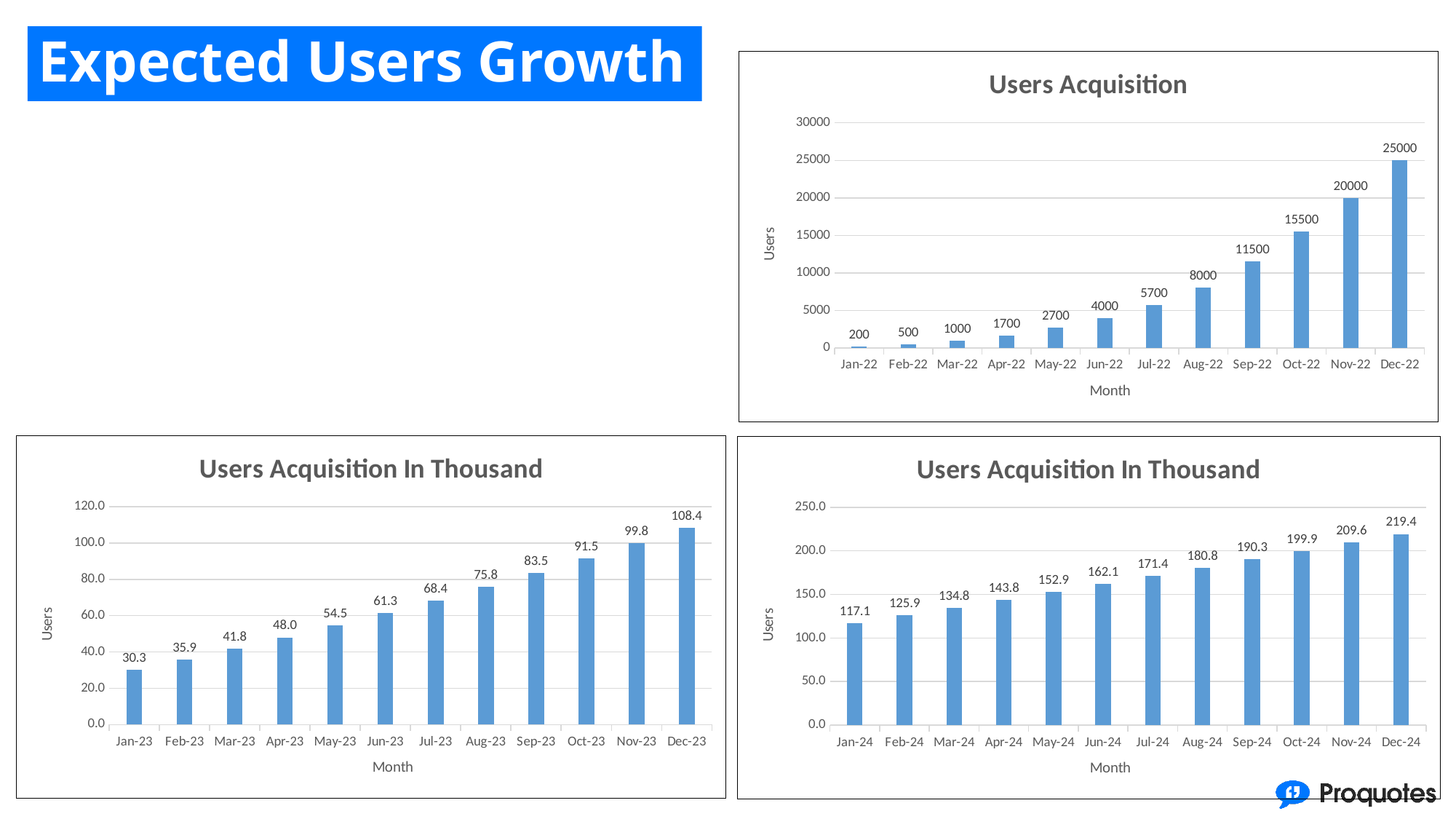
In the top-right chart titled 'Users Acquisition', which month has the lowest value? Jan-22 In the bottom-left chart titled 'Users Acquisition In Thousand', what is the difference between the values for Dec-23 and Jan-23? 78.1 In the top-right chart titled 'Users Acquisition', which month has the highest value? Dec-22 In the top-right chart titled 'Users Acquisition', what is the difference between the values for Dec-22 and Nov-22? 5000 In the bottom-left chart titled 'Users Acquisition In Thousand', what is the value for Jun-23? 61.3 What kind of chart is the bottom-right chart titled 'Users Acquisition In Thousand'? bar chart In the bottom-right chart titled 'Users Acquisition In Thousand', which is larger, the value for Mar-24 or the value for Oct-24? Oct-24 In the bottom-left chart titled 'Users Acquisition In Thousand', do the values rise or fall from Jan-23 to Dec-23? rise In the top-right chart titled 'Users Acquisition', how many months are plotted? 12 In the bottom-right chart titled 'Users Acquisition In Thousand', what is the value for Aug-24? 180.8 In the top-right chart titled 'Users Acquisition', what is the value for Sep-22? 11500 What is the y-axis label of the top-right chart titled 'Users Acquisition'? Users